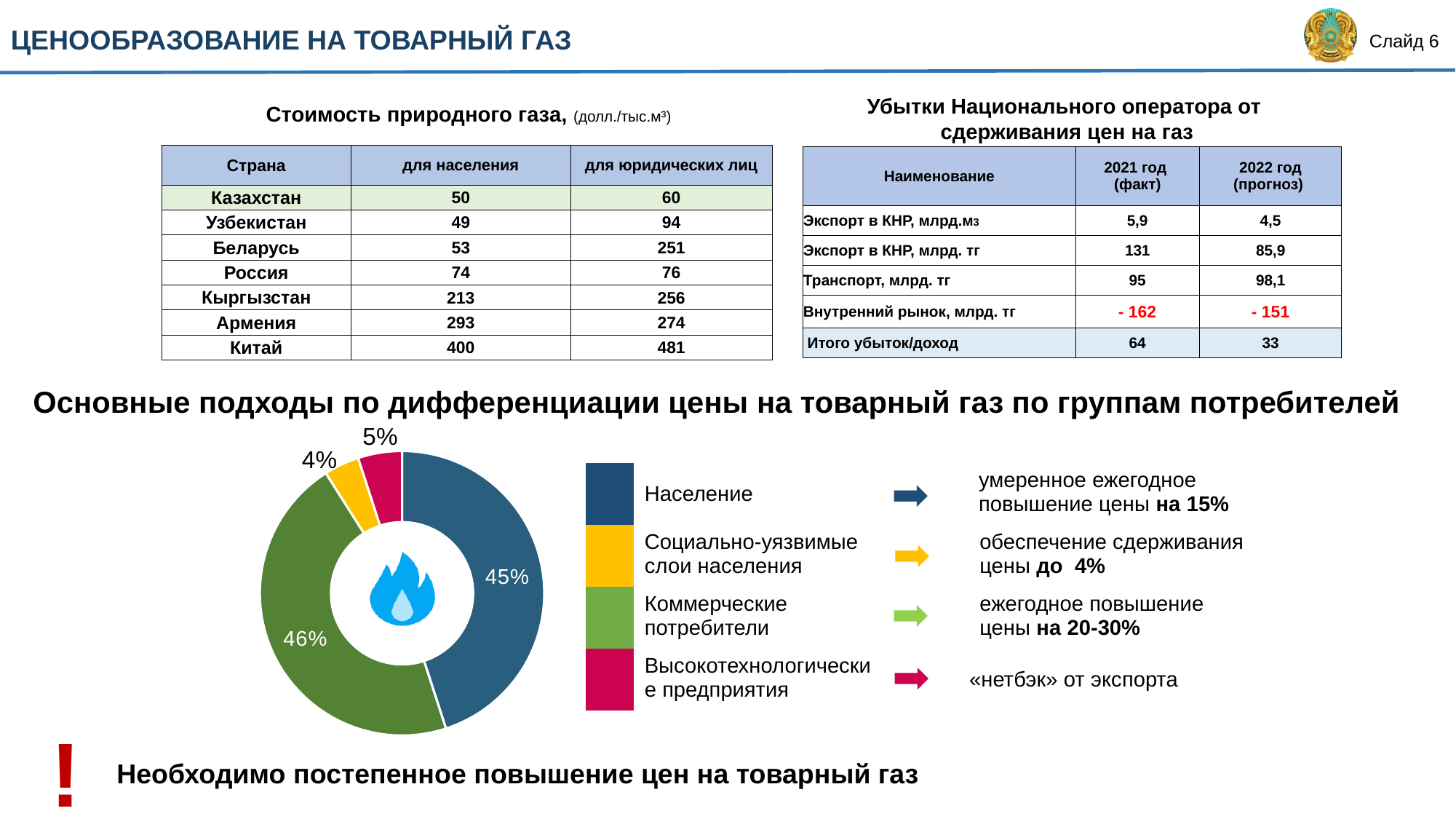
What colour is the Население slice in the pie chart? Dark blue What share of the pie chart is labelled for Коммерческие потребители? 46% What kind of chart is shown in the lower part of the slide? Pie chart (donut) Which slice is larger: Высокотехнологические предприятия or Социально-уязвимые слои населения? Высокотехнологические предприятия How many slices does the pie chart have? 4 Which category has the smallest slice in the pie chart? Социально-уязвимые слои населения By how many percentage points does the Коммерческие потребители slice exceed the Население slice? 1 percentage point How many entries does the legend of the pie chart list? 4 What share of the pie chart is labelled for Высокотехнологические предприятия? 5% What share of the pie chart is labelled for Население? 45% What share of the pie chart is labelled for Социально-уязвимые слои населения? 4% Which category has the largest slice in the pie chart? Коммерческие потребители